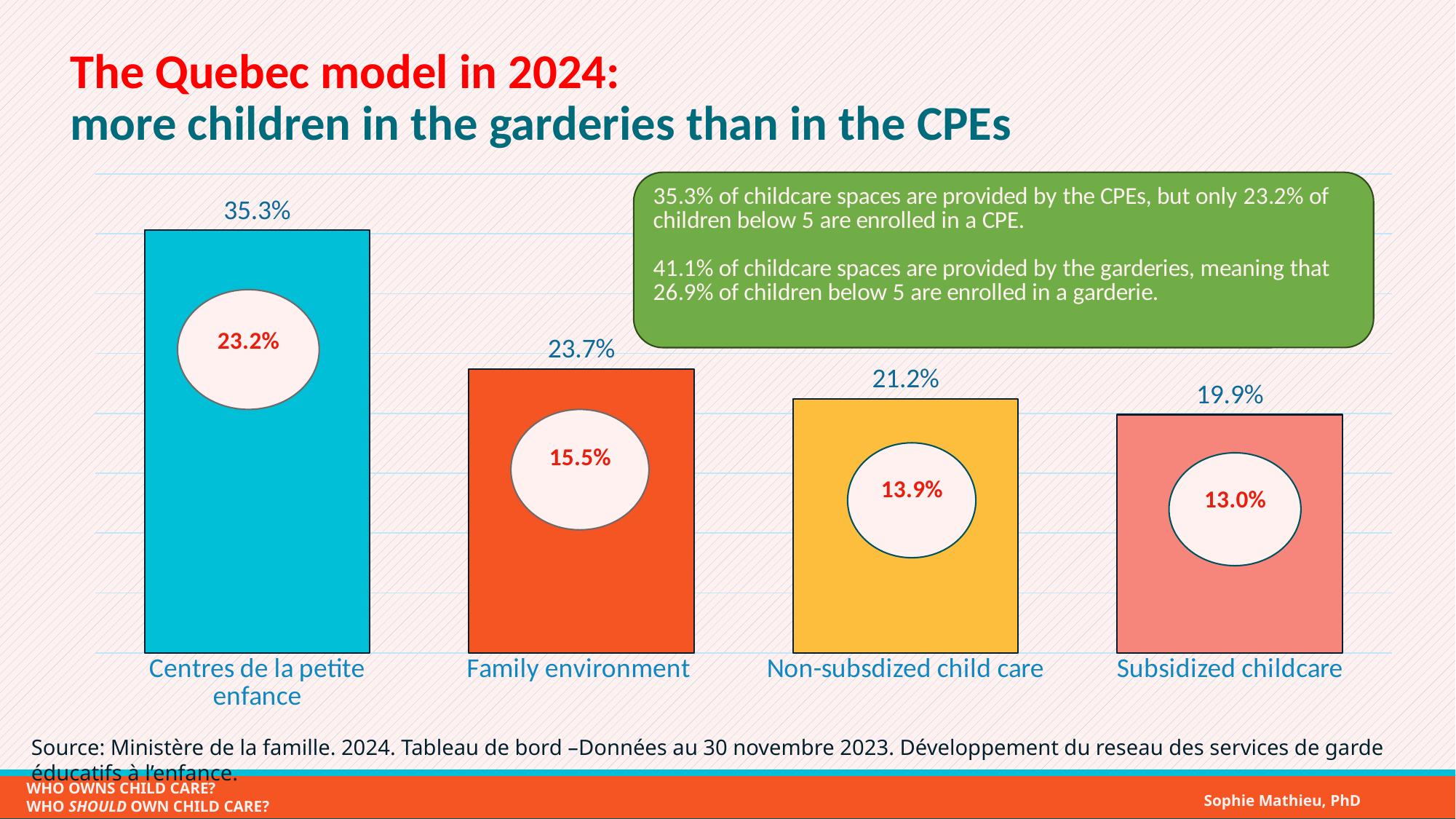
What is the difference between the bar values for Centres de la petite enfance and Family environment? 11.6% What value is shown above the bar for Non-subsdized child care? 21.2% What value is shown above the bar for Centres de la petite enfance? 35.3% What value is shown above the bar for Subsidized childcare? 19.9% What value is printed in the circle inside the Subsidized childcare bar? 13.0% Which category has the shortest bar? Subsidized childcare Do the bar values rise or fall from left to right across the categories? fall What value is printed in the circle inside the Centres de la petite enfance bar? 23.2% Which bar is taller, Non-subsdized child care or Subsidized childcare? Non-subsdized child care Which category has the tallest bar? Centres de la petite enfance What value is shown above the bar for Family environment? 23.7% How many categories are shown on the x axis? 4